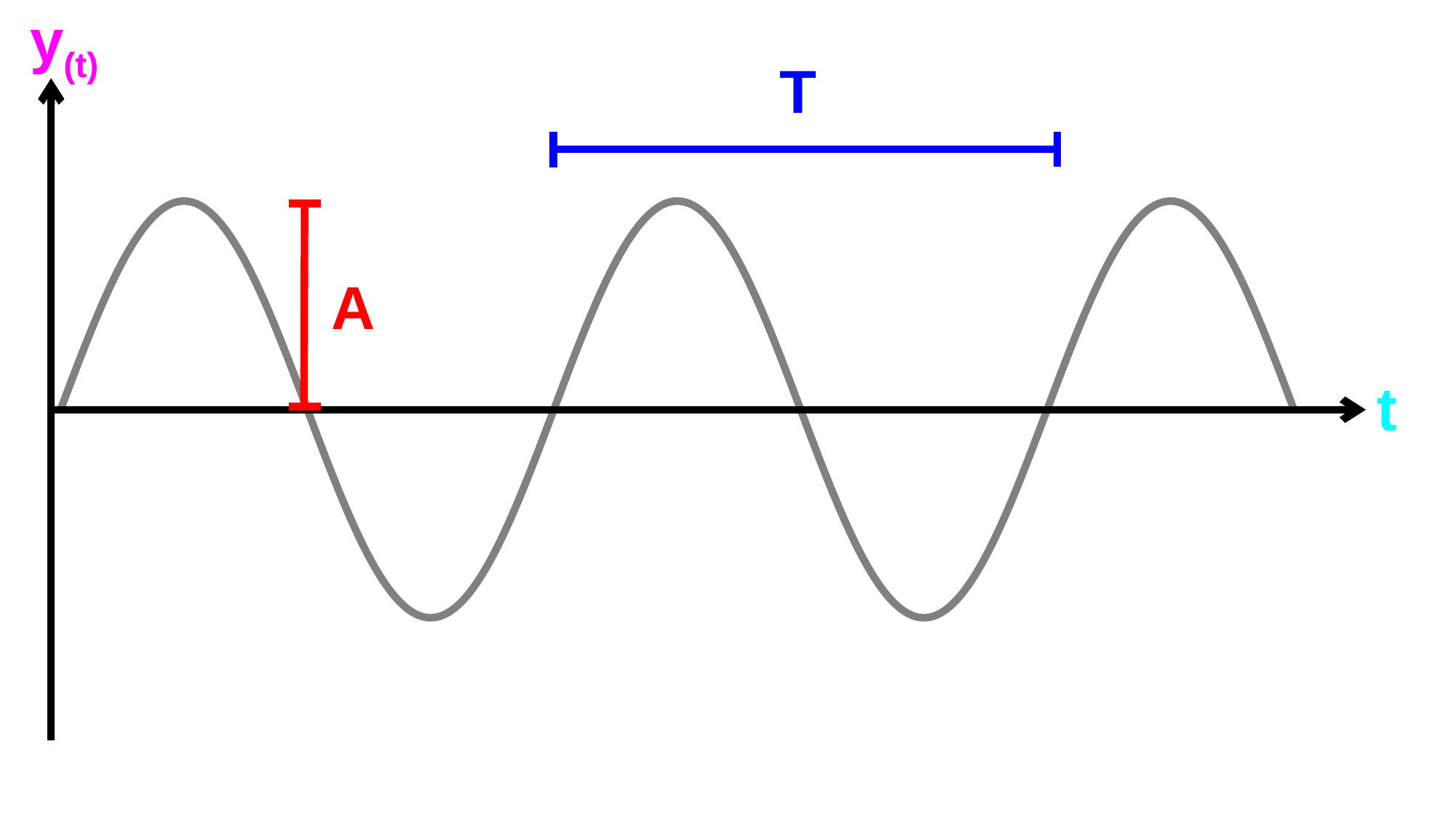
Does the plotted curve rise or fall immediately after the origin along the t axis? rise What is the label on the horizontal axis? t How many peaks (maxima) does the plotted wave show above the t axis? 3 How many troughs (minima) does the plotted wave show below the t axis? 2 What kind of chart is shown on the slide? line chart What is the label on the vertical axis? y(t)